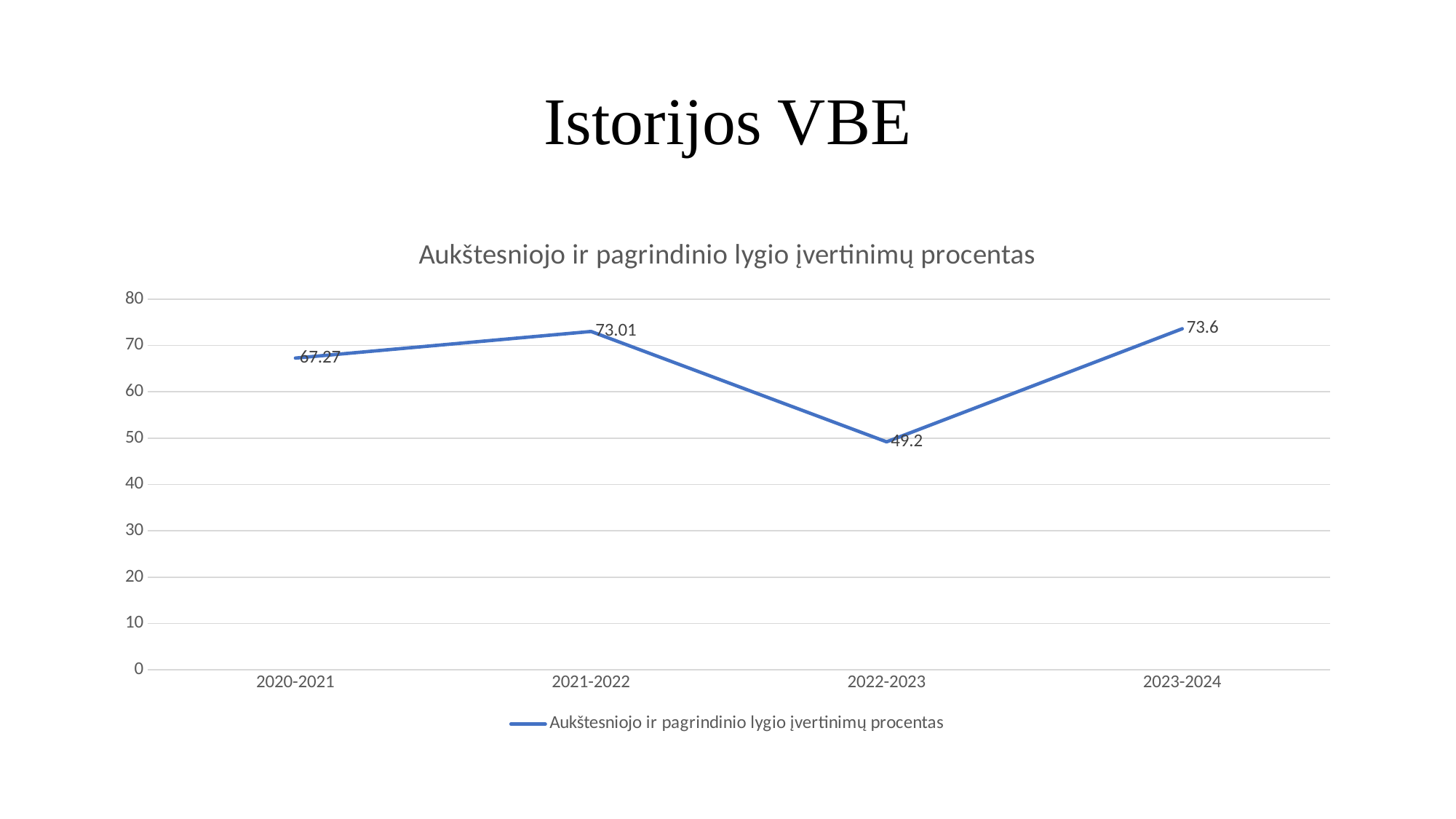
What is the value for 2021-2022? 73.01 What is the difference between the values for 2021-2022 and 2022-2023? 23.81 Is the value for 2022-2023 greater or less than 50? less What is the value for 2023-2024? 73.6 What is the value for 2020-2021? 67.27 What is the value for 2022-2023? 49.2 What kind of chart is shown on the slide? line chart How many data points are plotted on the chart? 4 What is the title of the chart? Aukštesniojo ir pagrindinio lygio įvertinimų procentas Which year has the lowest value? 2022-2023 Which year has the highest value? 2023-2024 Which is larger, the value for 2020-2021 or the value for 2021-2022? 2021-2022